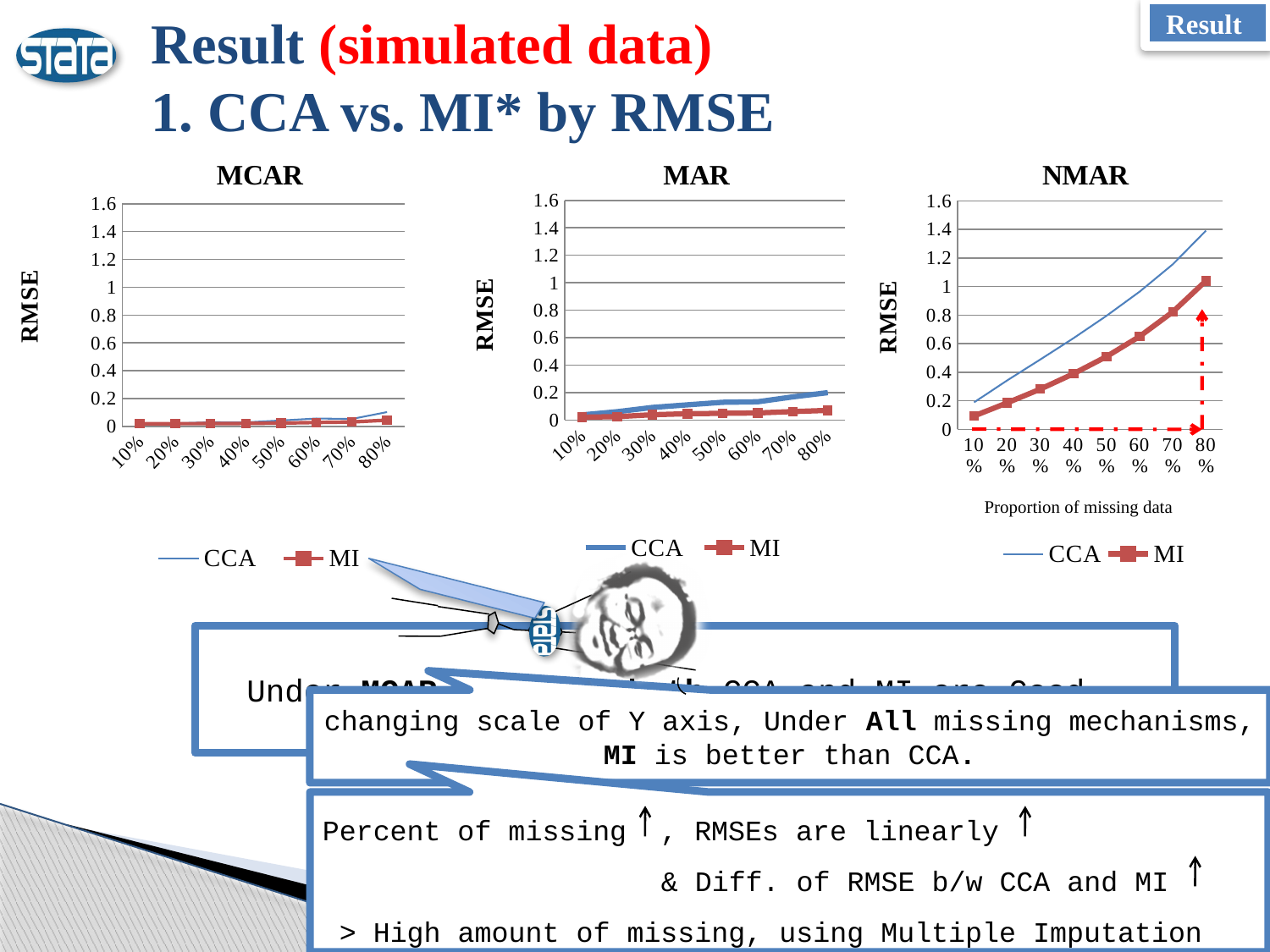
What is the label on the y axis of the MCAR chart? RMSE In the NMAR chart, is the CCA value at 80% greater or less than 1.2? greater In the MAR chart, which series has the larger value at 80%, CCA or MI? CCA How many points are plotted along the x axis for each series in the MAR chart? 8 In the NMAR chart, which series has the larger value at 80%, CCA or MI? CCA In the NMAR chart, is the CCA value at 10% greater or less than 0.4? less In the NMAR chart, is the MI value at 80% greater or less than 0.8? greater What kind of chart is the MCAR chart? line chart What is the x-axis label shown under the NMAR chart? Proportion of missing data How many series does the legend of the NMAR chart list? 2 In the NMAR chart, does the CCA series rise or fall as the proportion of missing data increases from 10% to 80%? rise